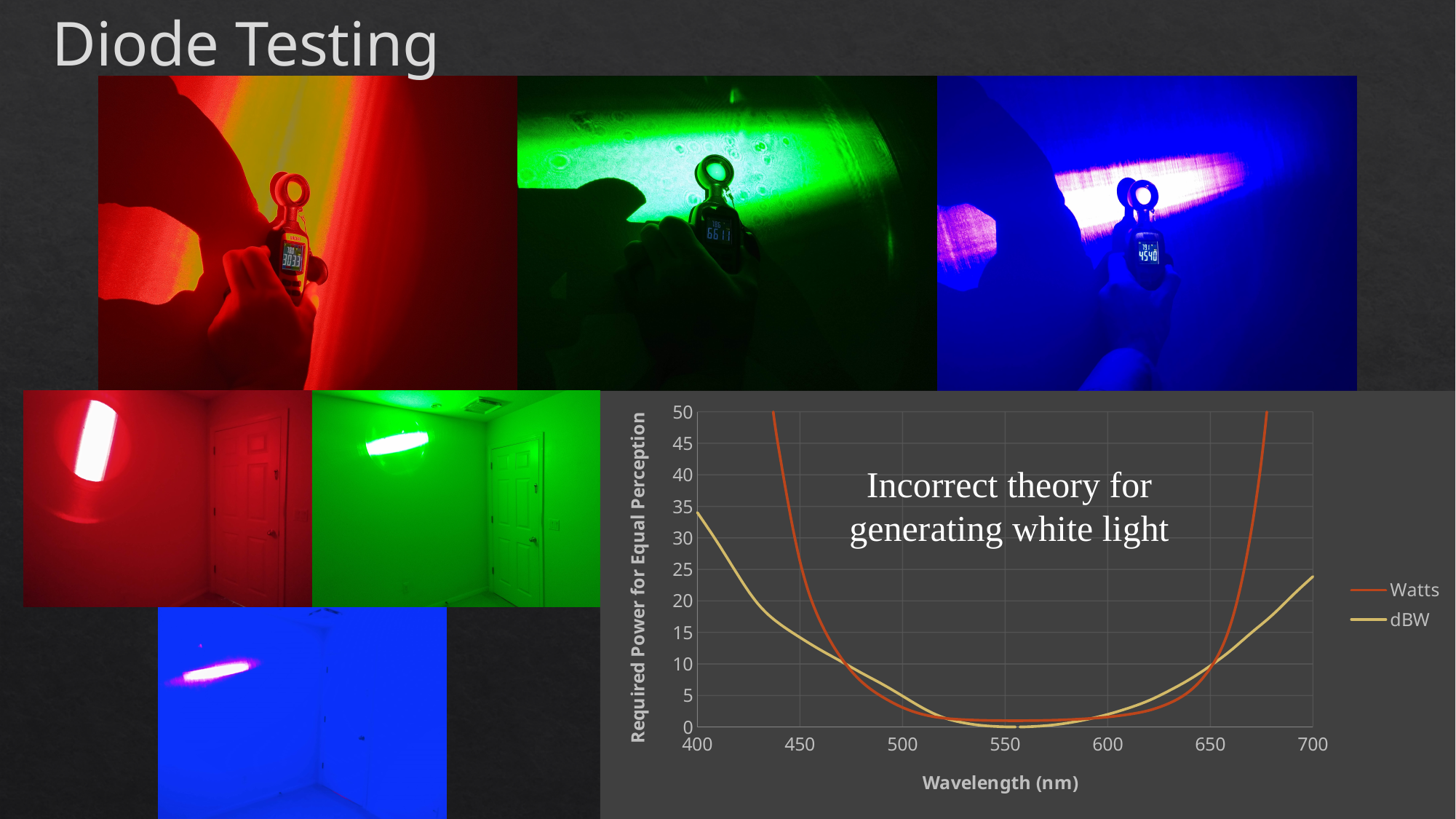
What is the title of the chart's x axis? Wavelength (nm) Does the dBW line rise or fall as wavelength increases from 400 nm to 550 nm? fall Is the dBW value at 700 nm greater or less than 20? greater Is the dBW value at 400 nm greater or less than 30? greater At 500 nm, which series has the higher value, Watts or dBW? dBW At 700 nm, which series has the higher value, Watts or dBW? Watts What kind of chart is shown on the slide? line chart How many series does the chart's legend list? 2 Is the Watts value at 500 nm greater or less than 5? less What are the two series named in the chart's legend? Watts and dBW